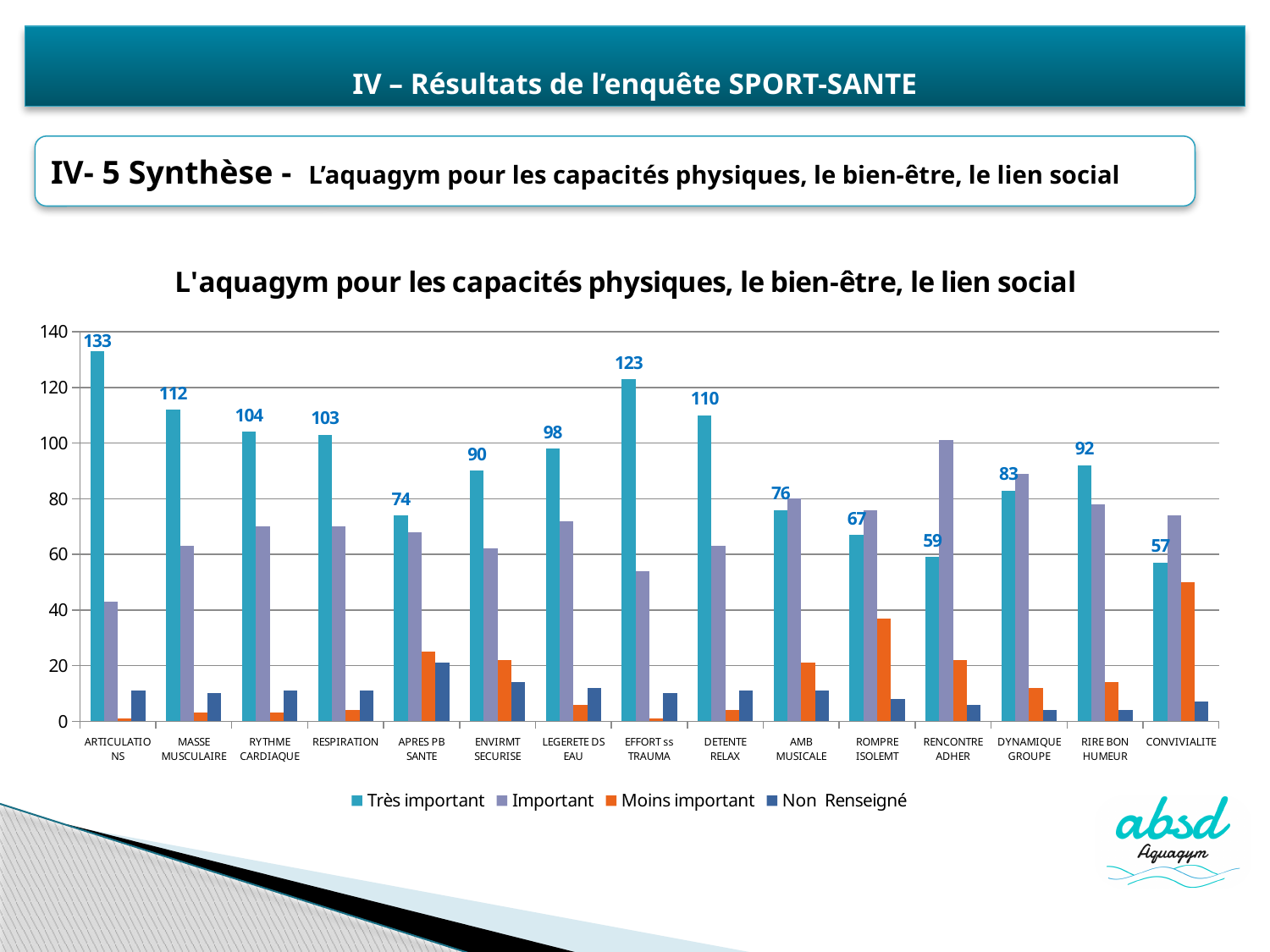
What is the difference between the 'Très important' values for ARTICULATIONS and MASSE MUSCULAIRE? 21 What is the 'Très important' value for RENCONTRE ADHER? 59 Which category has the highest 'Très important' value? ARTICULATIONS Is the 'Moins important' value for ROMPRE ISOLEMT greater or less than 40? less How many series does the legend list? 4 How many categories are shown on the x axis? 15 What kind of chart is shown on the slide? Bar chart What is the 'Très important' value for EFFORT ss TRAUMA? 123 Which category has the lowest 'Très important' value? CONVIVIALITE Is the 'Important' value for EFFORT ss TRAUMA greater or less than 60? less What is the 'Très important' value for ARTICULATIONS? 133 Which has a larger 'Très important' value, DETENTE RELAX or RIRE BON HUMEUR? DETENTE RELAX